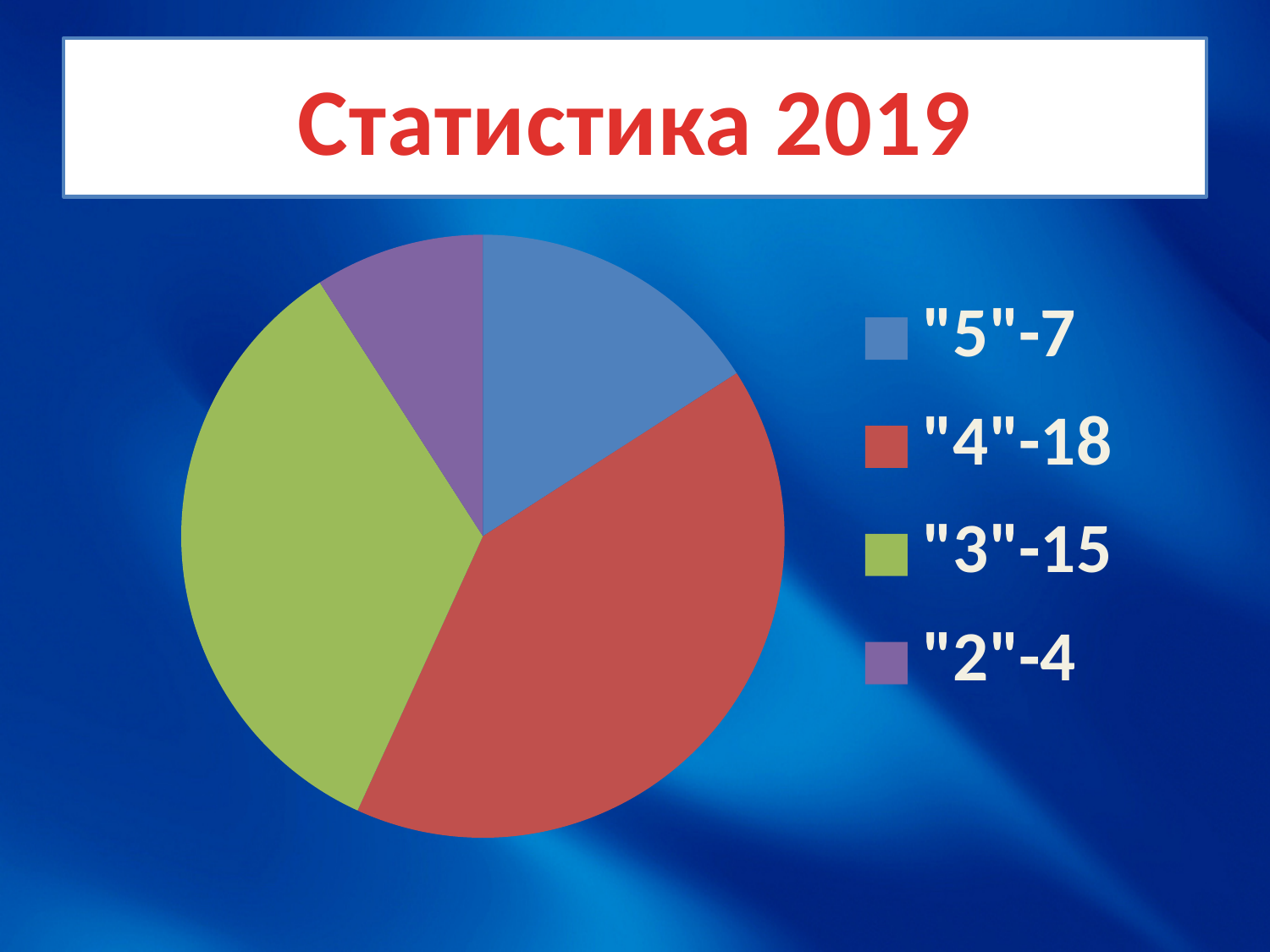
What is the difference between the values for "4" and "3"? 3 What value is given for the "4" category in the legend? 18 Which is larger, the value for "5" or the value for "2"? "5" What kind of chart is shown on the slide? pie chart Which category has the largest slice of the pie? "4" What value is given for the "2" category in the legend? 4 What value is given for the "5" category in the legend? 7 What colour is the slice for the "3" category? green How many slices does the pie chart have? 4 Which category has the smallest slice of the pie? "2" What value is given for the "3" category in the legend? 15 What is the title of the chart on the slide? Статистика 2019